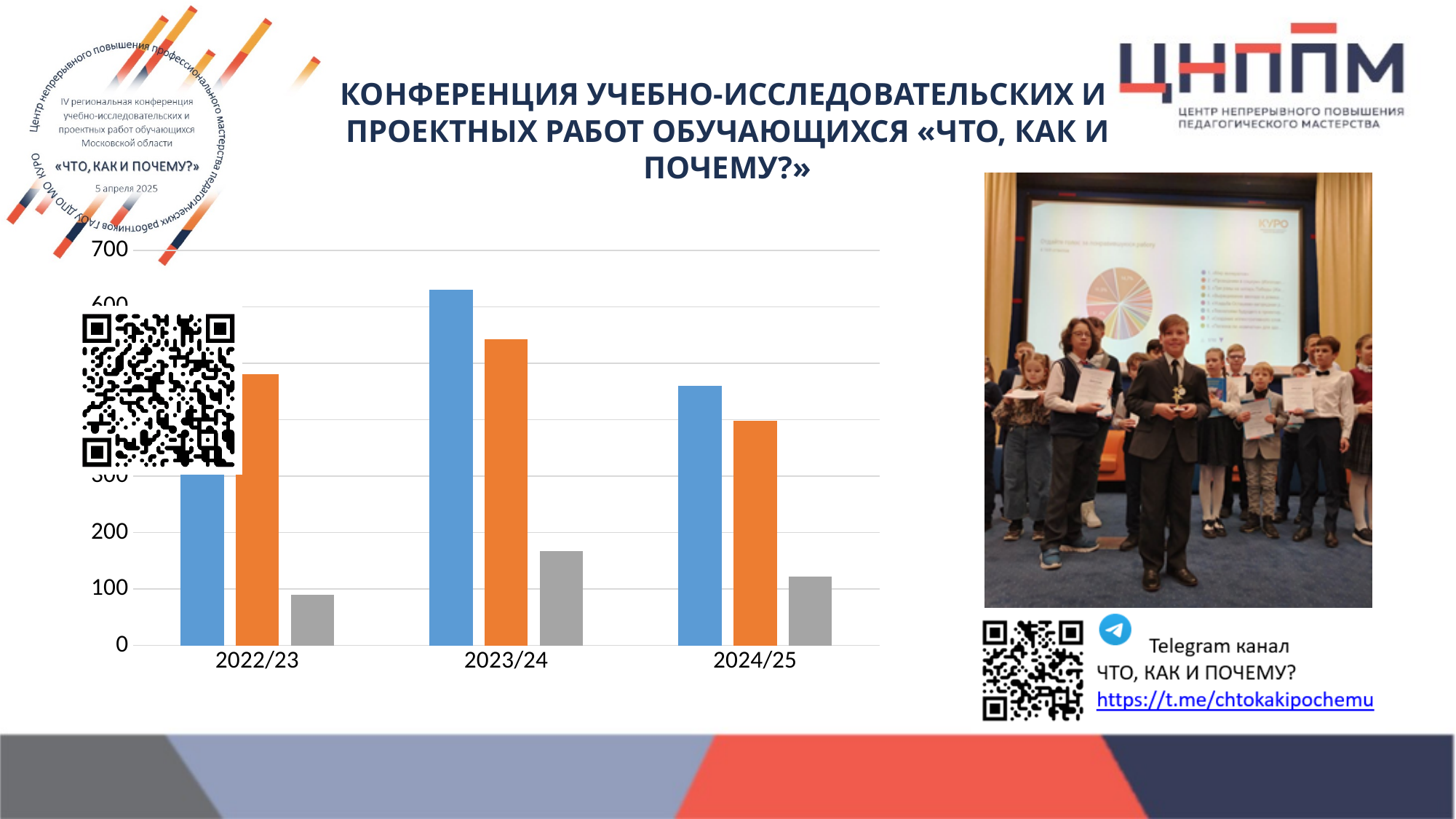
Which academic year has the shortest bar in the chart? 2022/23 Is the value of the blue bar for 2023/24 greater or less than 600? greater How many bars are plotted for each academic year in the chart? 3 Is the value of the gray bar for 2023/24 greater or less than 200? less How many categories are shown on the x axis of the chart? 3 Is the value of the blue bar for 2024/25 greater or less than 500? less Does the blue series rise or fall from 2023/24 to 2024/25? fall Which academic year has the tallest bar in the chart? 2023/24 What kind of chart is shown on the slide? bar chart For 2023/24, which is larger: the blue bar or the orange bar? the blue bar